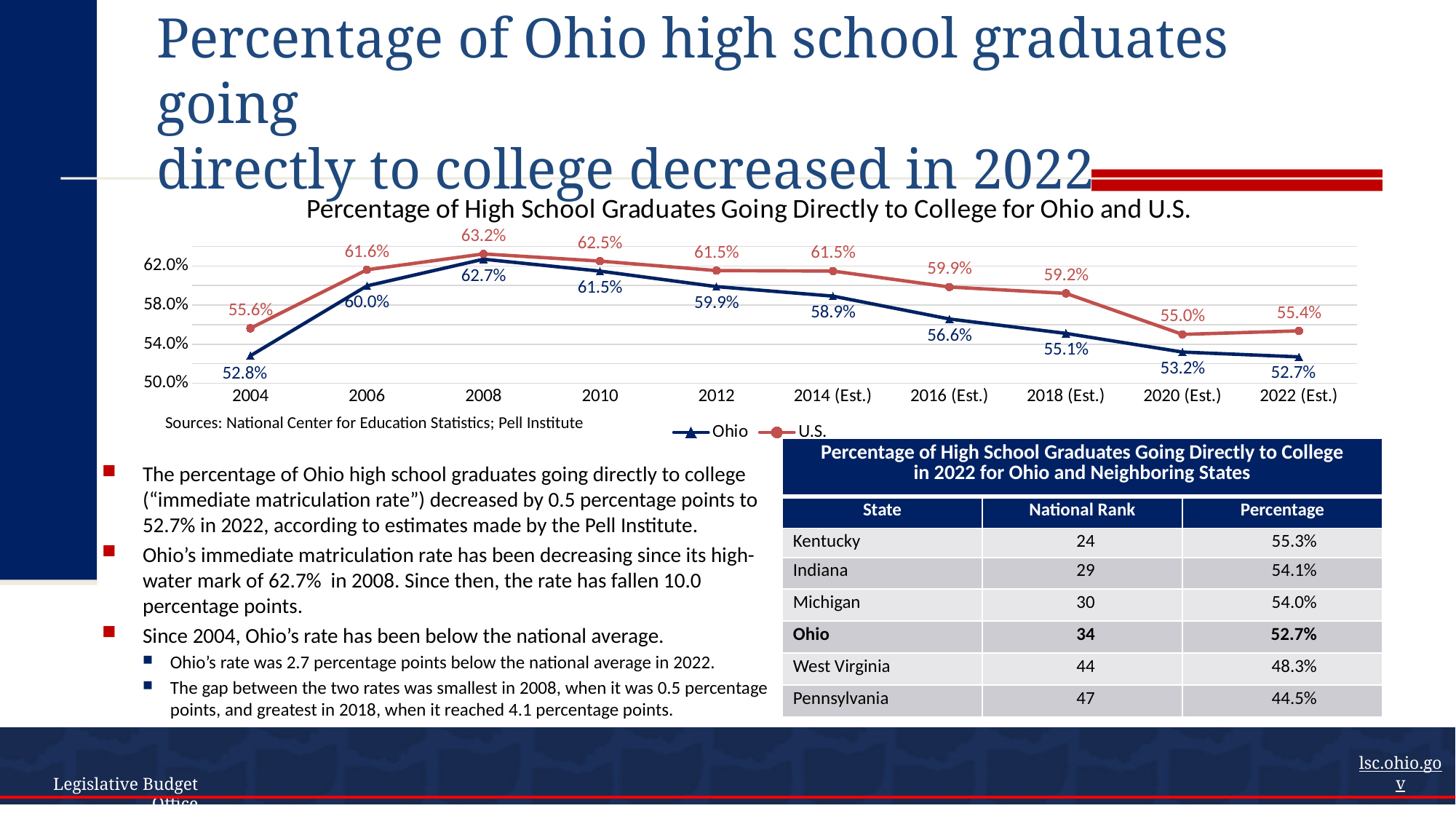
What is the U.S. value for 2022 (Est.)? 55.4% In which year does the U.S. series reach its highest value? 2008 What kind of chart is shown on the slide? Line chart What is the Ohio value for 2008? 62.7% What is the Ohio value for 2016 (Est.)? 56.6% How many years are plotted on the x axis? 10 How many series does the legend list? 2 In which year is the Ohio series at its lowest value? 2022 (Est.) What is the difference between the U.S. and Ohio values in 2018 (Est.)? 4.1 percentage points Which series has the higher value in 2004, Ohio or U.S.? U.S. What is the difference between the Ohio values for 2008 and 2022 (Est.)? 10.0 percentage points Does the Ohio series rise or fall from 2008 to 2022 (Est.)? Fall